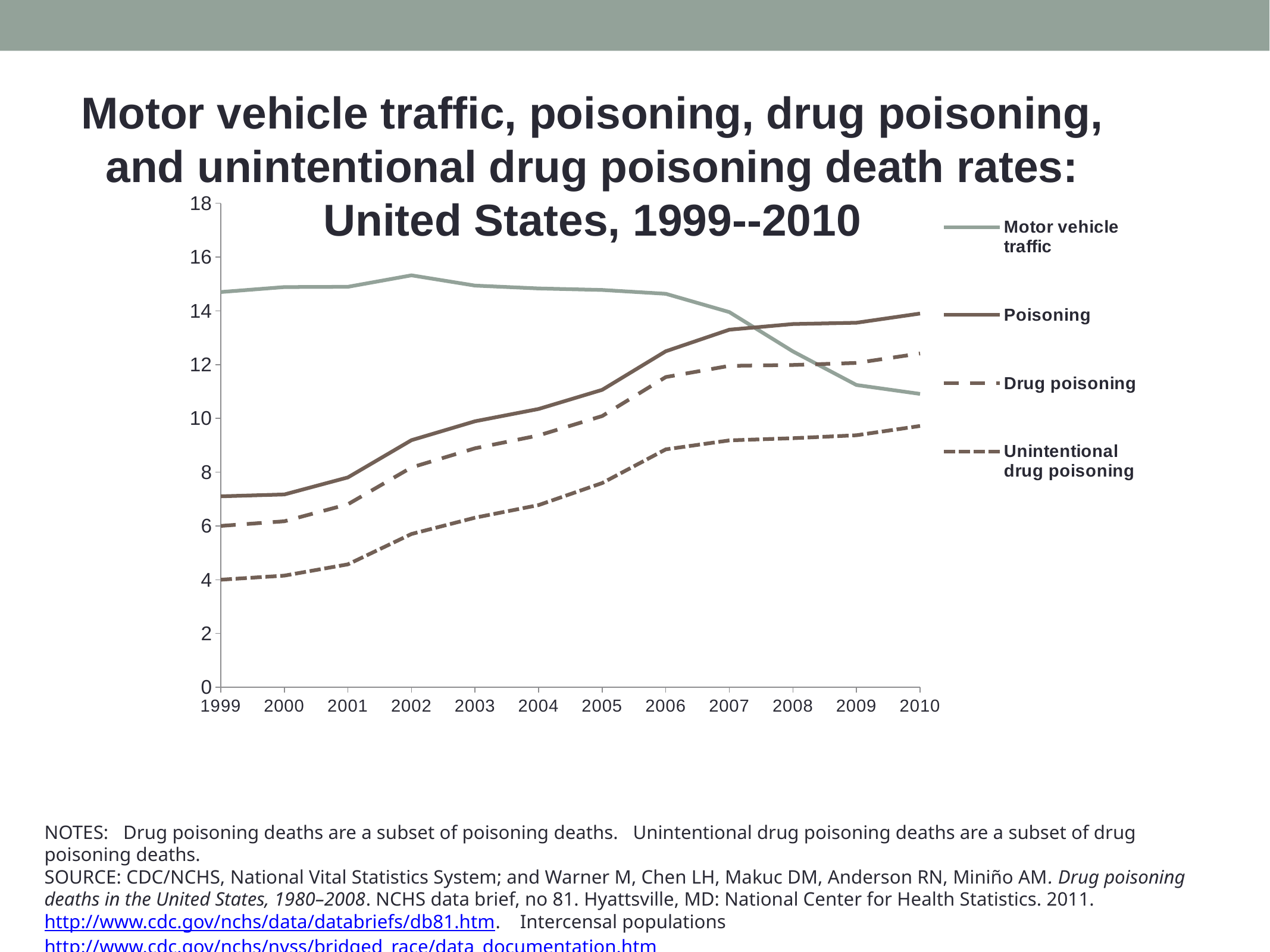
Which series is drawn with a solid grey line in the legend? Motor vehicle traffic Is the value for Unintentional drug poisoning in 1999 greater or less than 6? less Does the Poisoning death rate rise or fall from 1999 to 2010? Rise Which series has the lowest value in 2010? Unintentional drug poisoning How many years are plotted along the x axis? 12 In 2010, which is larger: the Poisoning rate or the Motor vehicle traffic rate? Poisoning How many series does the legend list? 4 Which series has the highest value in 1999? Motor vehicle traffic Does the Motor vehicle traffic death rate rise or fall from 2006 to 2010? Fall In 1999, which is larger: the Motor vehicle traffic rate or the Poisoning rate? Motor vehicle traffic Is the value for Motor vehicle traffic in 1999 greater or less than 14? greater What kind of chart is shown on the slide? Line chart